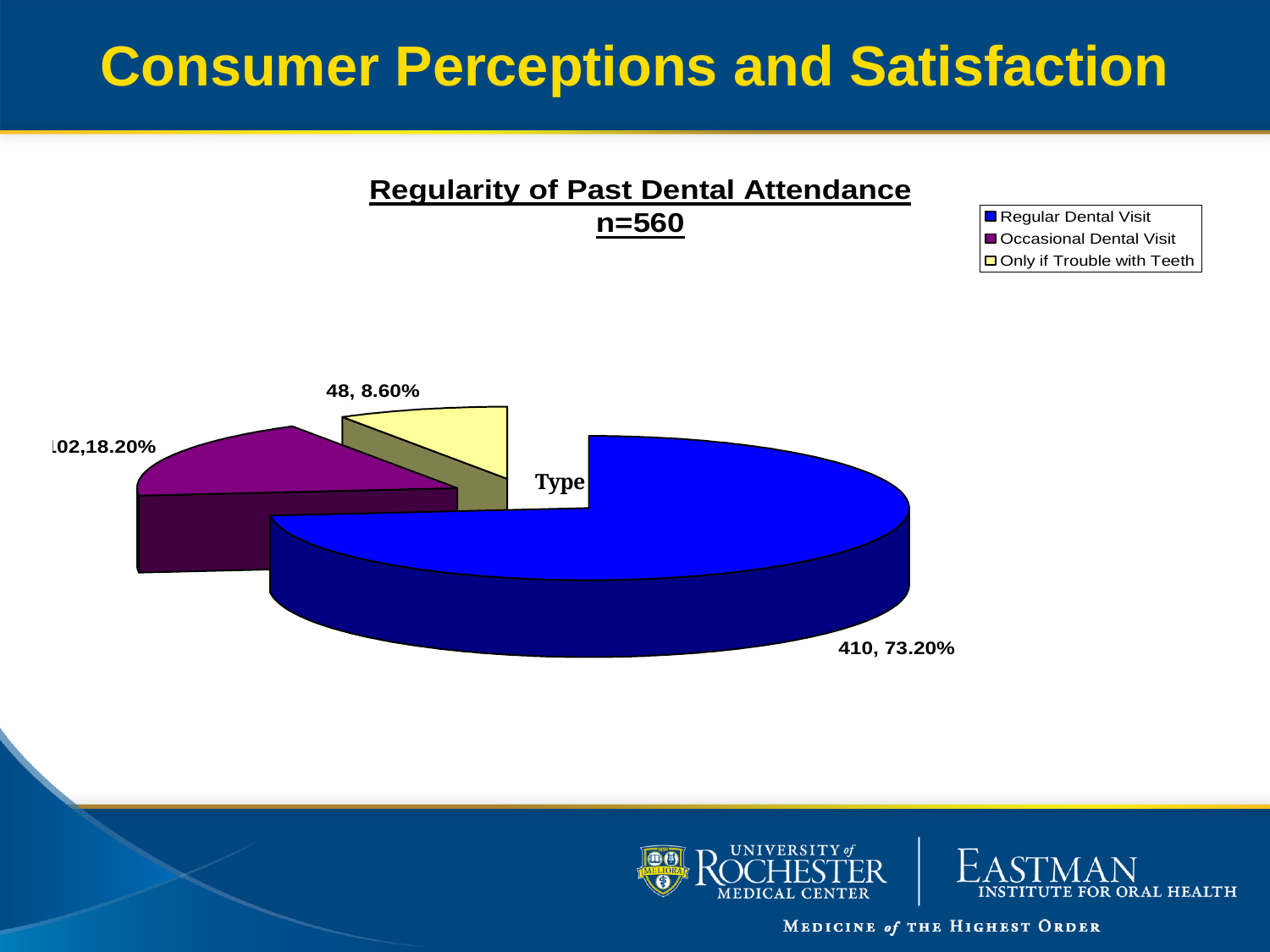
How many respondents reported visiting Only if Trouble with Teeth? 48 How many entries does the legend list? 3 What share of the pie is Regular Dental Visit? 73.20% What kind of chart is shown on the slide? Pie chart What is the sample size (n) stated in the chart title? 560 Which category has the largest slice of the pie? Regular Dental Visit What share of the pie is Only if Trouble with Teeth? 8.60% Which category has the smallest slice of the pie? Only if Trouble with Teeth How many respondents reported a Regular Dental Visit? 410 What is the difference between the number of Regular Dental Visit respondents and the number of Only if Trouble with Teeth respondents? 362 What share of the pie is Occasional Dental Visit? 18.20% How many slices does the pie chart have? 3